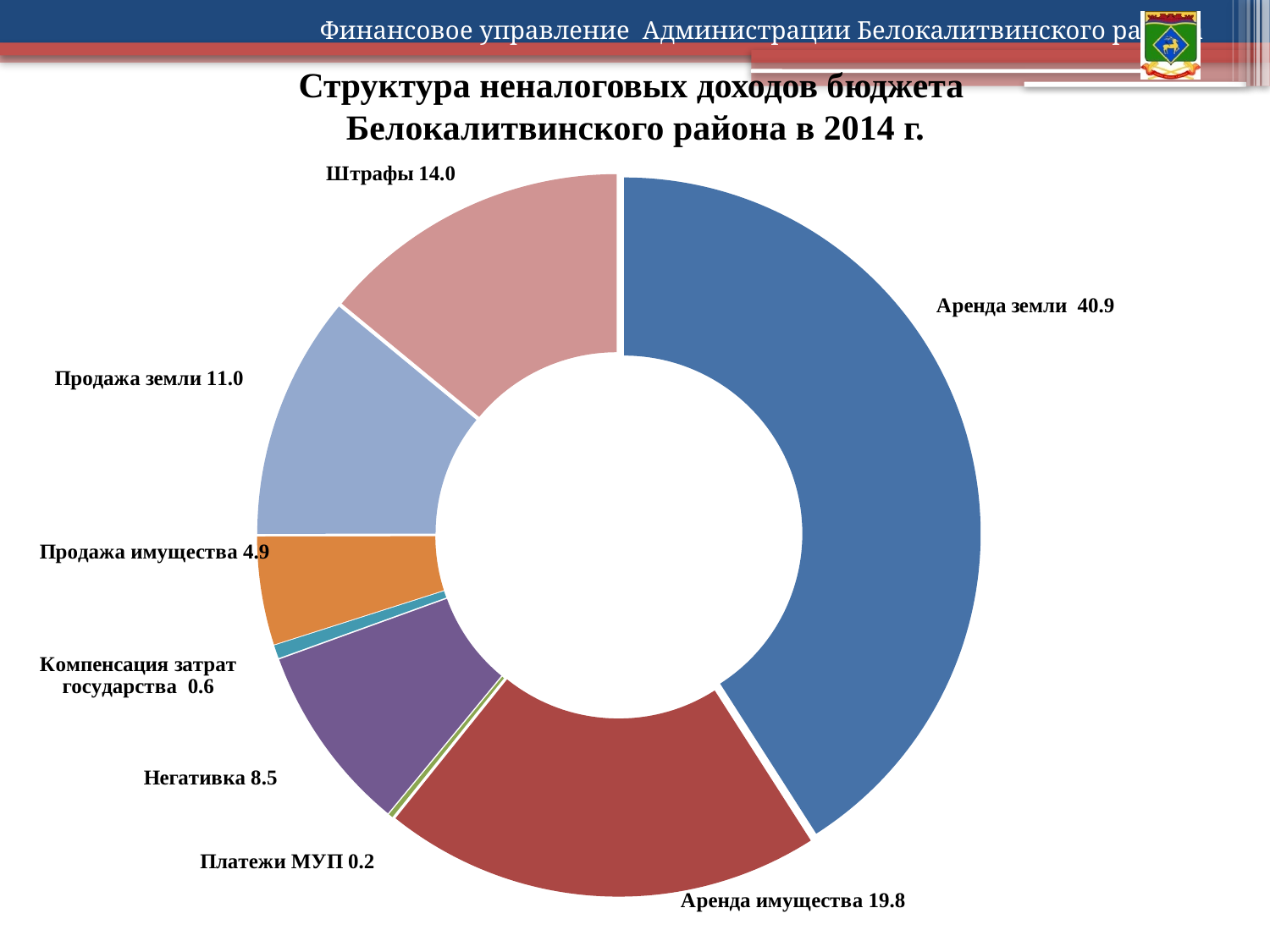
Which category has the largest share of the chart? Аренда земли What is the value for Аренда земли? 40.9 What is the title of the chart? Структура неналоговых доходов бюджета Белокалитвинского района в 2014 г. What is the value for Компенсация затрат государства? 0.6 Which category has the smallest share of the chart? Платежи МУП What is the value for Штрафы? 14.0 What is the value for Аренда имущества? 19.8 How many categories are shown in the chart? 8 What kind of chart is shown on the slide? Doughnut (pie) chart What is the difference between the values for Аренда земли and Аренда имущества? 21.1 Which is larger, Негативка or Продажа имущества? Негативка What is the difference between the values for Штрафы and Продажа земли? 3.0